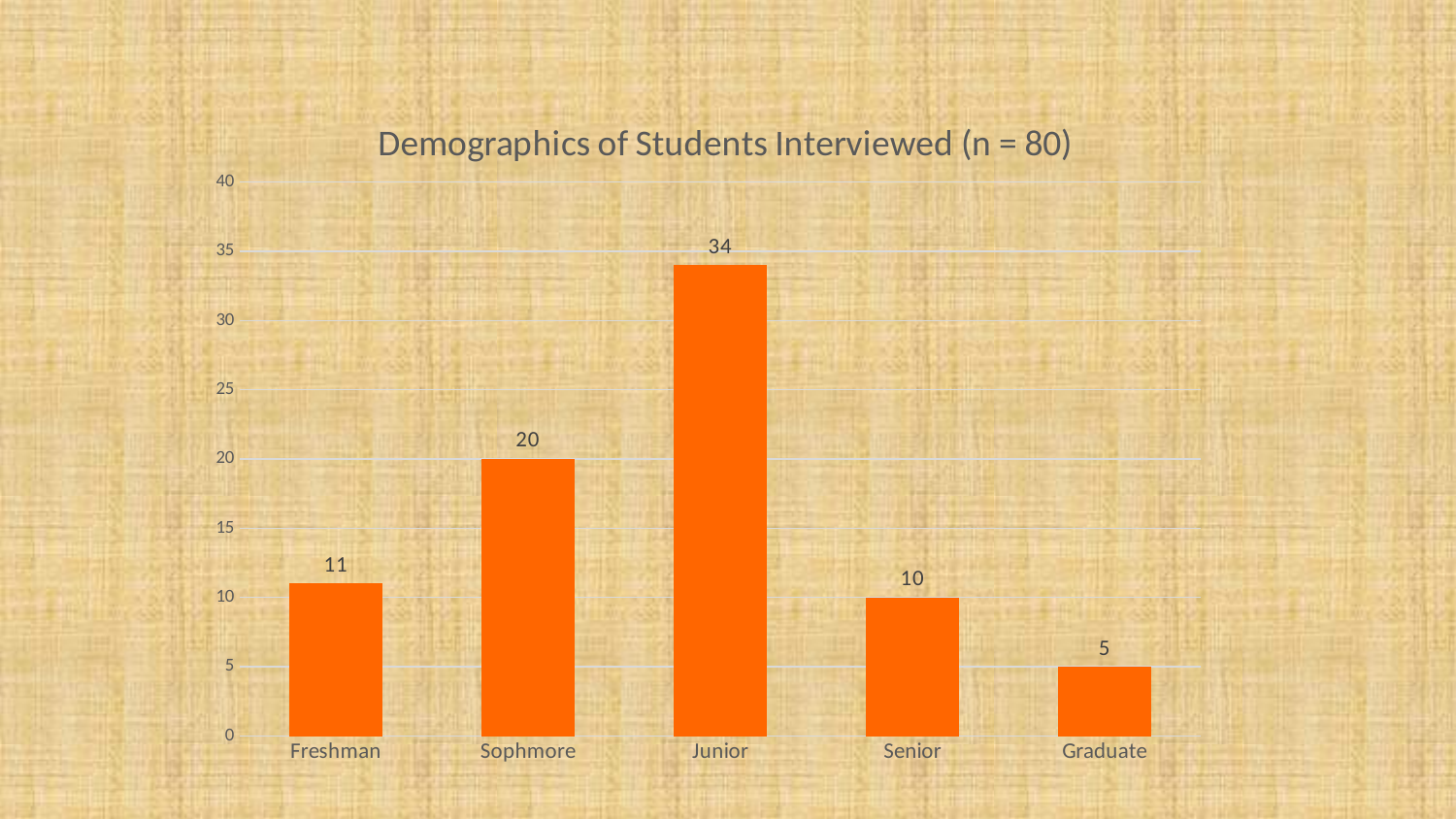
How many categories are shown on the x axis? 5 What is the title of the chart? Demographics of Students Interviewed (n = 80) Which category has the highest value? Junior Which is larger, the value for Freshman or the value for Senior? Freshman Which category has the lowest value? Graduate What colour are the bars? orange What kind of chart is this? bar chart What is the value for Freshman? 11 What is the value for Junior? 34 What is the difference between the values for Junior and Sophmore? 14 What is the value for Graduate? 5 Is the value for Sophmore greater or less than 15? greater